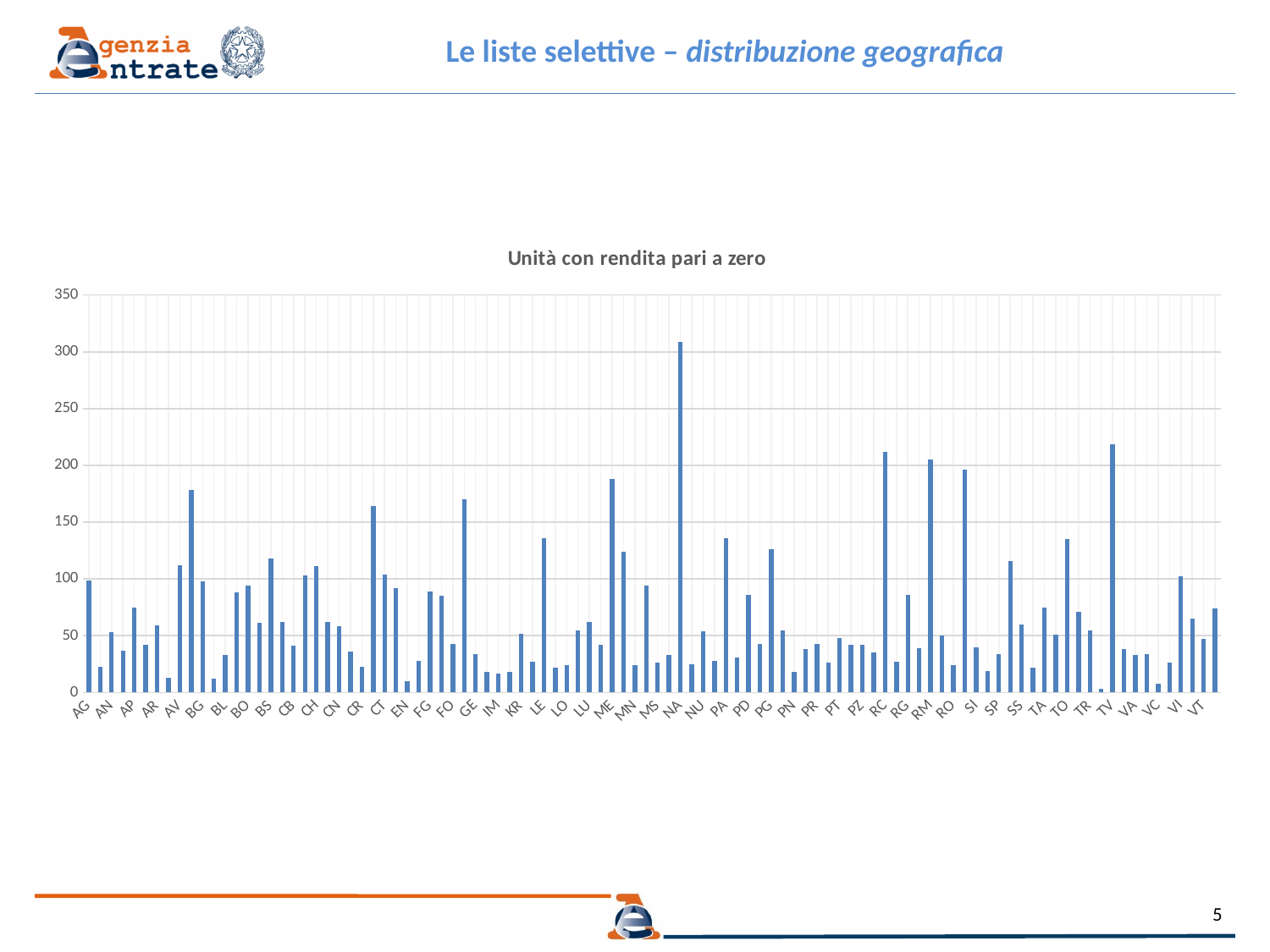
Which has a larger value, VT or EN? VT Is the value for ME greater or less than 150? greater Is the value for GE greater or less than 150? less Is the value for EN greater or less than 50? less Which province has the highest value in the chart? NA What is the title of the chart? Unità con rendita pari a zero Which has a larger value, NA or TV? NA What type of chart is shown on the slide? bar chart